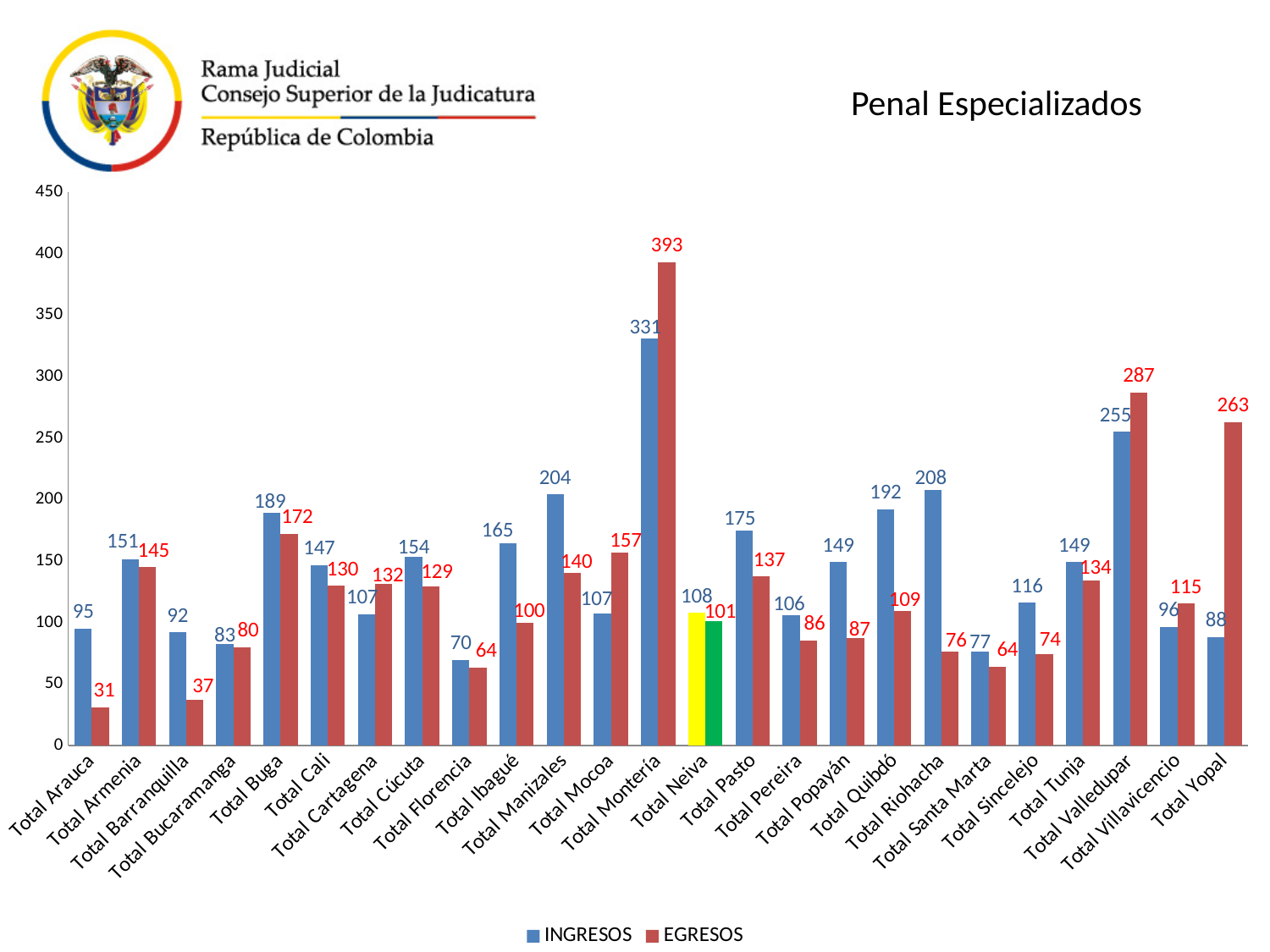
What is the title of the chart? Penal Especializados What kind of chart is shown on the slide? Bar chart Which is larger for Total Riohacha, INGRESOS or EGRESOS? INGRESOS How many series does the legend list? 2 How many categories are shown on the x axis? 25 Which category has the lowest EGRESOS value? Total Arauca What is the INGRESOS value for Total Neiva? 108 Which category has the lowest INGRESOS value? Total Florencia What is the EGRESOS value for Total Yopal? 263 What is the difference between EGRESOS and INGRESOS for Total Valledupar? 32 Which category has the highest EGRESOS value? Total Montería What is the INGRESOS value for Total Montería? 331